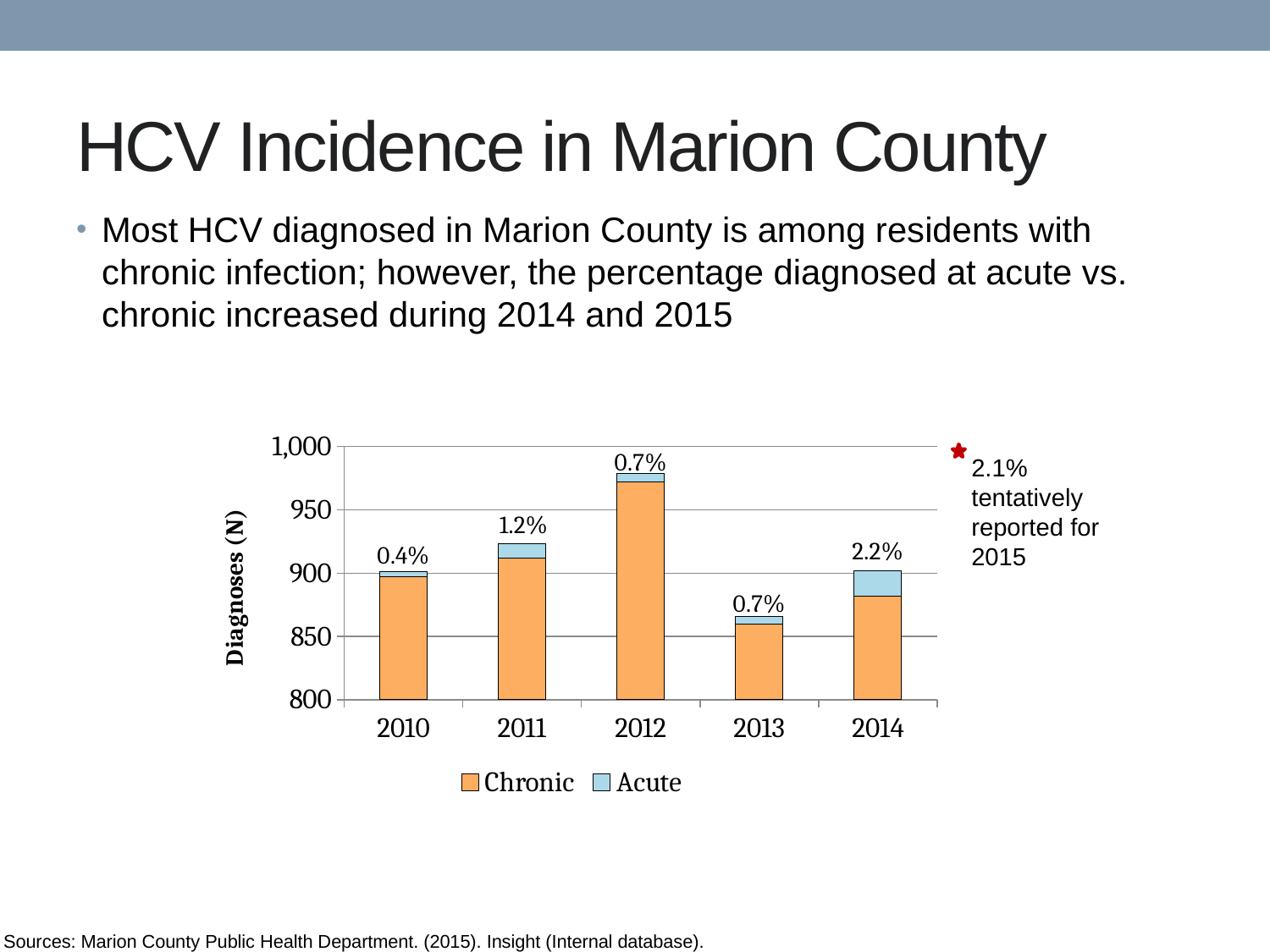
What is the difference between the percentage labels for 2014 and 2010? 1.8% Which year has the lowest percentage label on its bar? 2010 Which year has the tallest total bar? 2012 Which year has the highest percentage label on its bar? 2014 Is the total number of diagnoses for 2012 greater or less than 950? greater Is the total number of diagnoses for 2013 greater or less than 900? less Which year has the shortest total bar? 2013 How many years are shown on the x axis of the chart? 5 What percentage label is shown above the 2014 bar? 2.2% How many series does the chart legend list? 2 What percentage label is shown above the 2011 bar? 1.2% What percentage label is shown above the 2010 bar? 0.4%